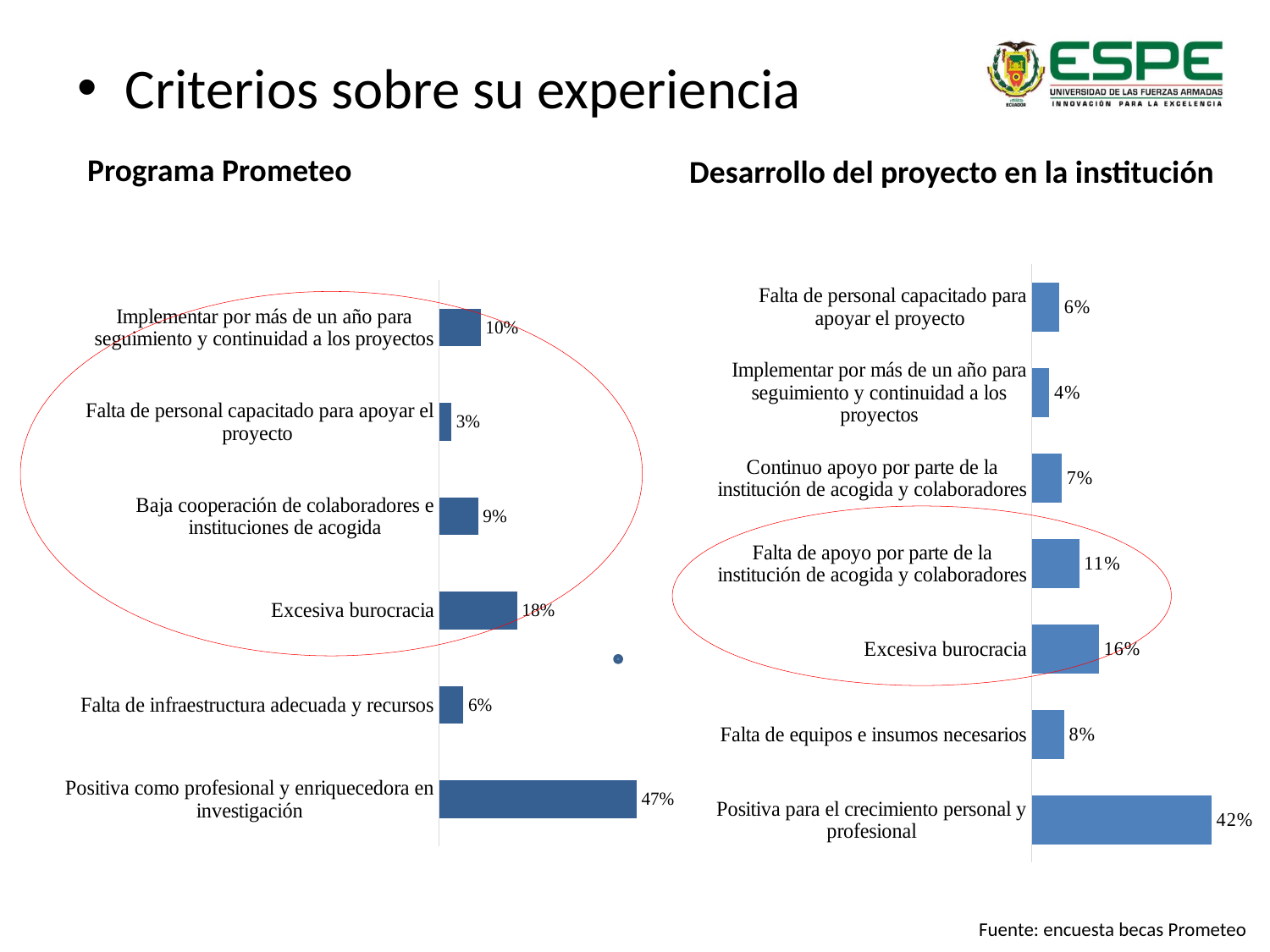
In the 'Desarrollo del proyecto en la institución' chart, which category has the lowest value? Implementar por más de un año para seguimiento y continuidad a los proyectos What type of chart is the 'Programa Prometeo' chart? Bar chart In the 'Desarrollo del proyecto en la institución' chart, what is the value for 'Positiva para el crecimiento personal y profesional'? 42% In the 'Desarrollo del proyecto en la institución' chart, what is the value for 'Falta de apoyo por parte de la institución de acogida y colaboradores'? 11% In the 'Desarrollo del proyecto en la institución' chart, which is larger: 'Excesiva burocracia' or 'Falta de equipos e insumos necesarios'? Excesiva burocracia In the 'Programa Prometeo' chart, which category has the lowest value? Falta de personal capacitado para apoyar el proyecto In the 'Programa Prometeo' chart, what is the difference between 'Positiva como profesional y enriquecedora en investigación' and 'Excesiva burocracia'? 29% In the 'Programa Prometeo' chart, what is the value for 'Excesiva burocracia'? 18% In the 'Programa Prometeo' chart, how many categories are shown? 6 In the 'Programa Prometeo' chart, which category has the highest value? Positiva como profesional y enriquecedora en investigación In the 'Programa Prometeo' chart, what is the value for 'Falta de personal capacitado para apoyar el proyecto'? 3% In the 'Desarrollo del proyecto en la institución' chart, how many categories are shown? 7